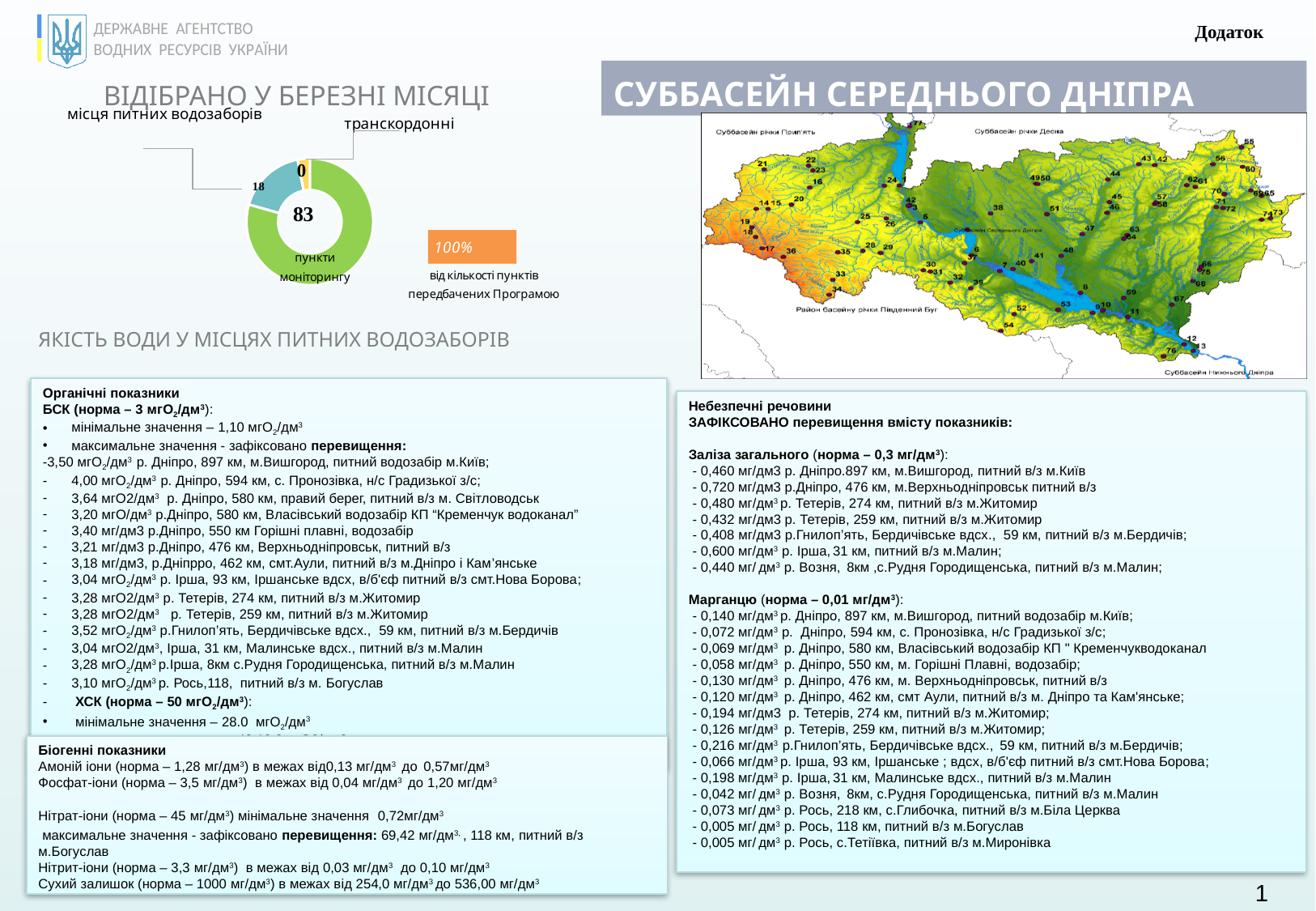
What type of chart is shown under the heading "ВІДІБРАНО У БЕРЕЗНІ МІСЯЦІ"? Doughnut (pie) chart How many categories are labelled in the doughnut chart? 3 Which category in the doughnut chart has the largest value? пункти моніторингу Which category in the doughnut chart has the smallest value? транскордонні What percentage is shown in the orange box next to the doughnut chart? 100% What number is shown in the centre of the doughnut chart for "пункти моніторингу"? 83 What value is shown for "транскордонні" in the doughnut chart? 0 In the doughnut chart, which is larger: "місця питних водозаборів" or "транскордонні"? місця питних водозаборів What is the difference between the value for "пункти моніторингу" (83) and "місця питних водозаборів" (18) in the doughnut chart? 65 What colour is the segment representing "місця питних водозаборів" in the doughnut chart? Blue What value is shown for "місця питних водозаборів" in the doughnut chart? 18